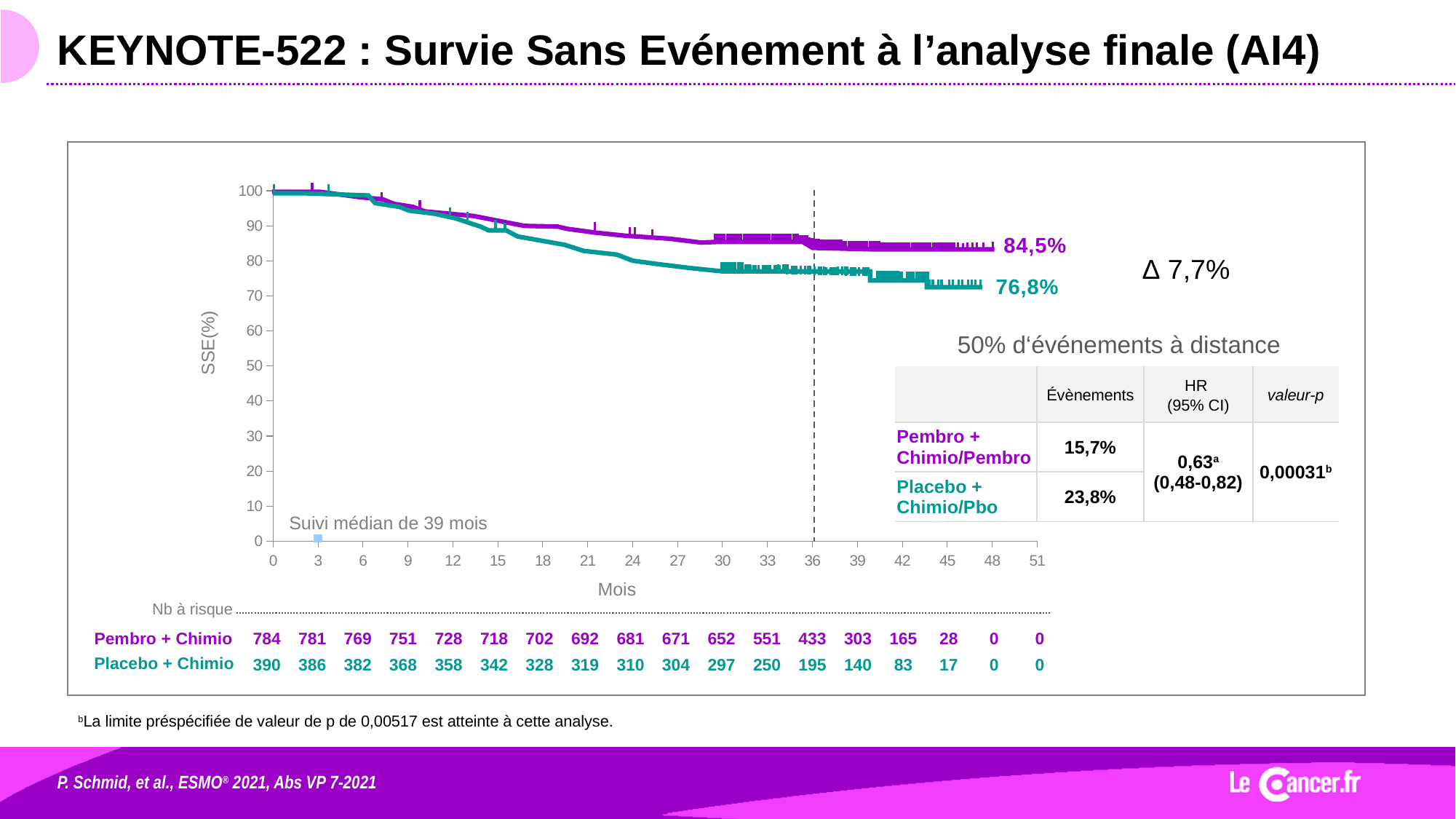
What is the label of the y axis? SSE(%) How many patients were at risk in the Pembro + Chimio group at month 0? 784 What is the difference (Δ) between the final SSE values of the two curves? 7,7% What is the event-free survival (SSE) value labelled at the end of the Pembro + Chimio curve? 84,5% Do the SSE curves rise or fall as the months increase along the x axis? Fall What percentage of events is reported for the Placebo + Chimio/Pbo group in the table? 23,8% What is the event-free survival (SSE) value labelled at the end of the Placebo + Chimio curve? 76,8% What kind of chart is shown on the slide? Line chart (Kaplan-Meier survival curve) How many patients were at risk in the Placebo + Chimio group at month 24? 310 How many treatment groups (series) are plotted on the chart? 2 Is the value of the Placebo + Chimio curve at 12 months greater or less than 80? greater Which curve ends higher, Pembro + Chimio or Placebo + Chimio? Pembro + Chimio